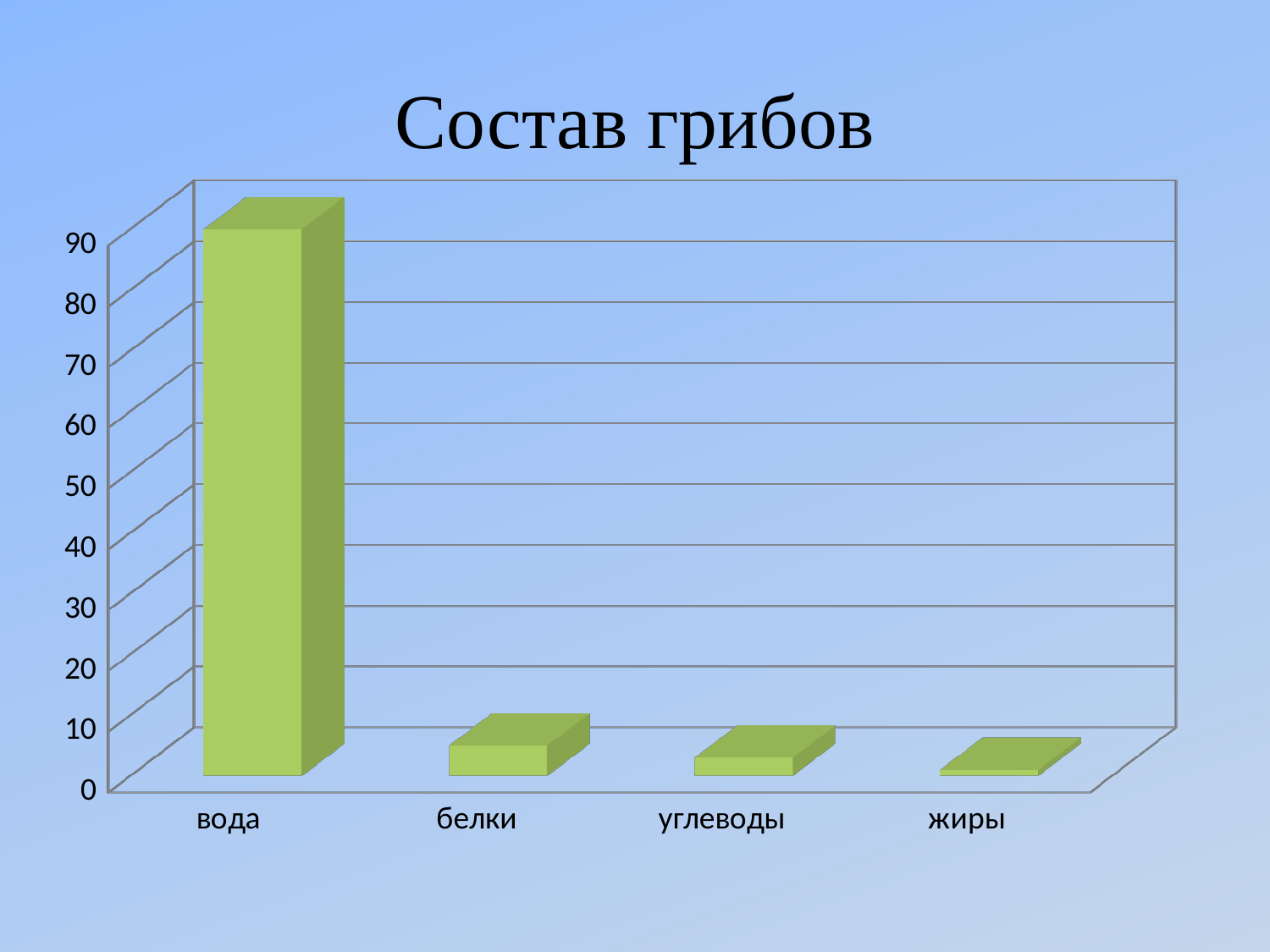
What kind of chart is shown on the slide? bar chart What is the title of the chart? Состав грибов Is the value for вода greater or less than 80? greater Which category has the lowest value in the chart? жиры Which is larger, the value for вода or the value for белки? вода Which category has the highest value in the chart? вода Is the value for углеводы greater or less than 10? less How many categories are shown on the x axis of the chart? 4 Is the value for жиры greater or less than 10? less What is the highest tick value shown on the vertical axis? 90 Which is larger, the value for белки or the value for жиры? белки